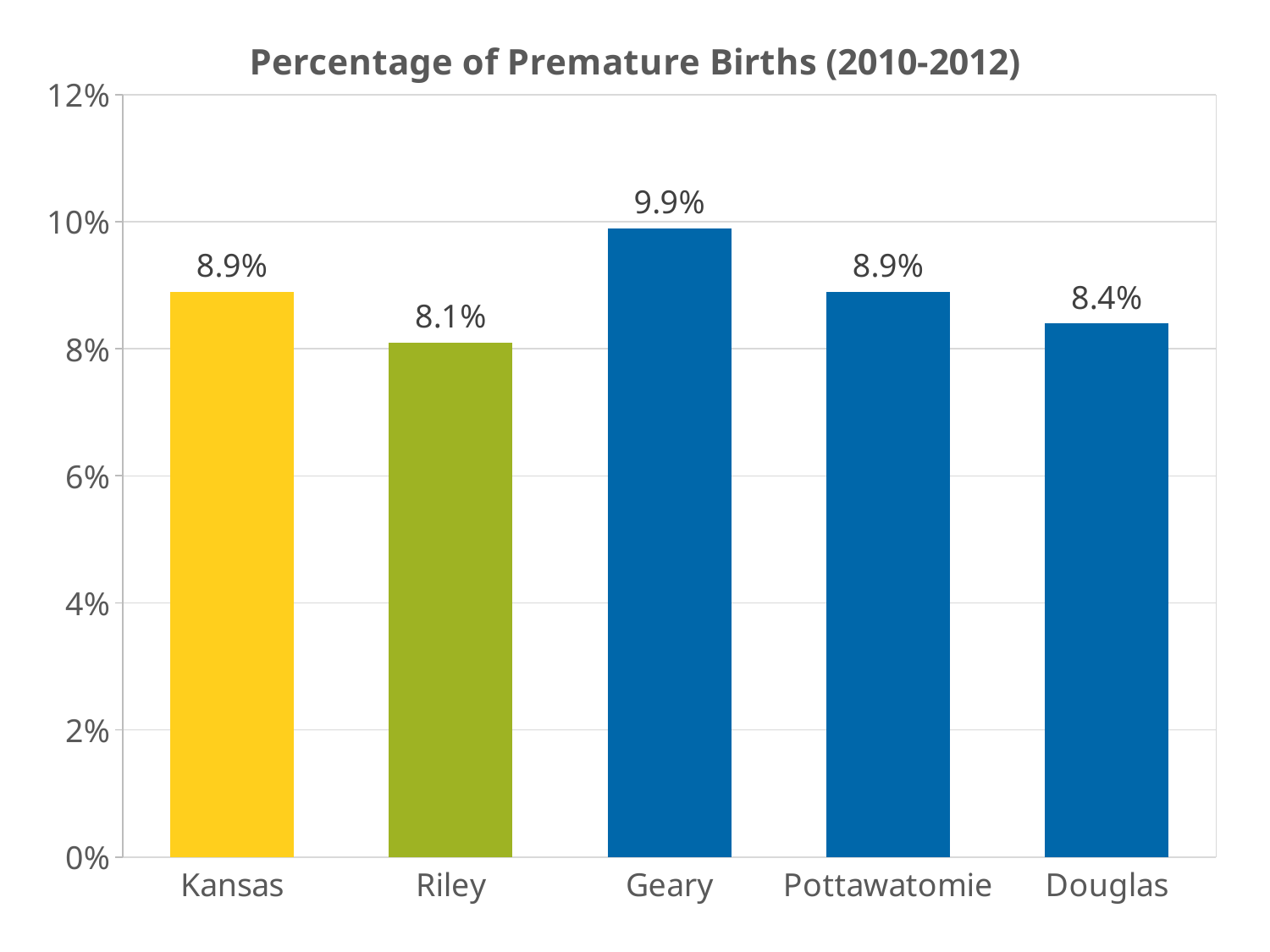
What is the percentage of premature births for Riley? 8.1% Which category has the highest percentage of premature births? Geary Which category has the lowest percentage of premature births? Riley What is the percentage of premature births for Kansas? 8.9% What is the percentage of premature births for Geary? 9.9% What kind of chart is shown on the slide? Bar chart Which is larger, the value for Pottawatomie or the value for Douglas? Pottawatomie What is the difference between the percentage for Geary and the percentage for Riley? 1.8% What is the percentage of premature births for Douglas? 8.4% What is the title of the chart? Percentage of Premature Births (2010-2012) Is the value for Geary greater or less than 8%? greater How many categories are shown on the x axis? 5